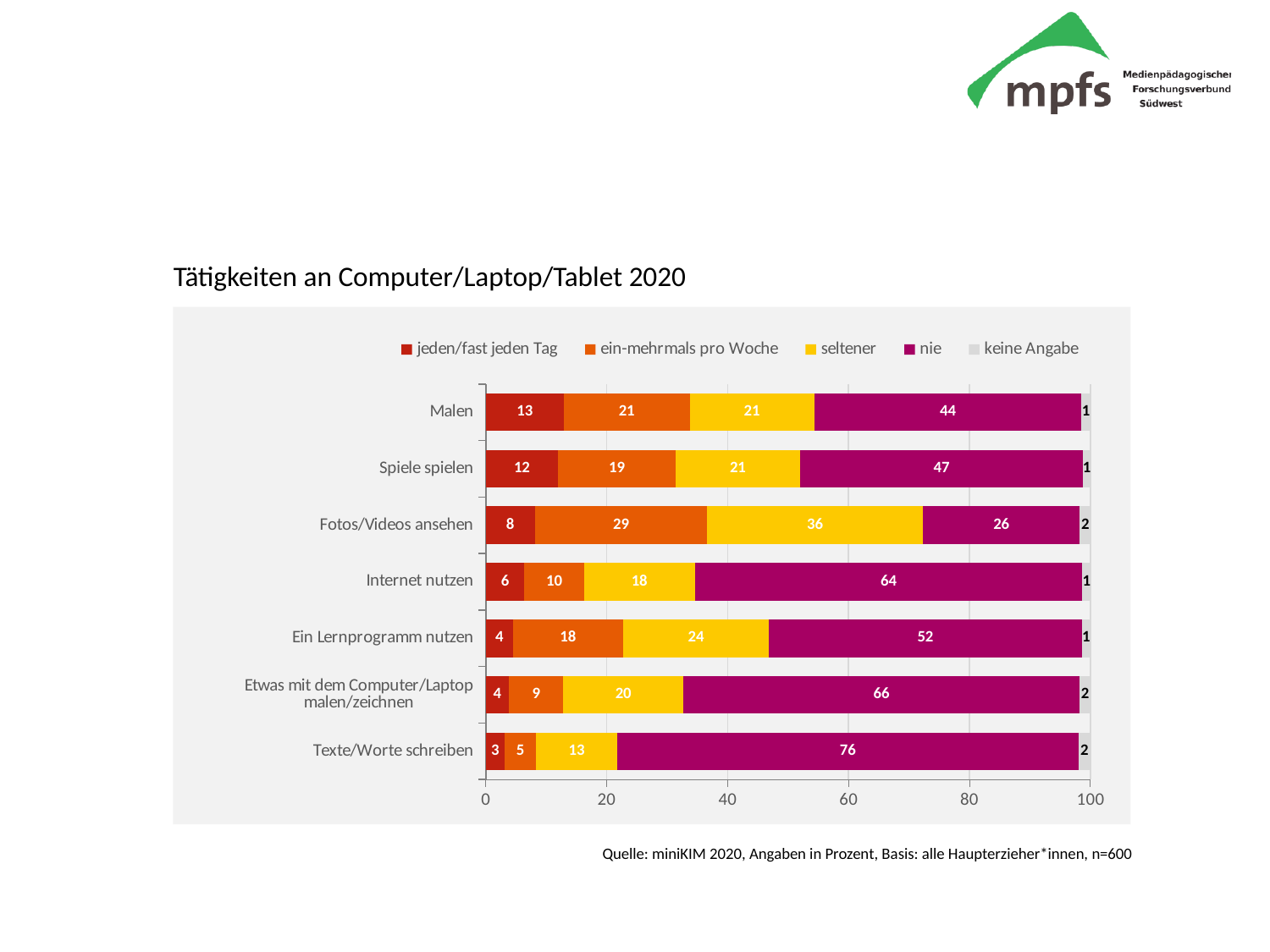
What is the value for "nie" for Texte/Worte schreiben? 76 What kind of chart is shown on the slide? Stacked bar chart How many series does the legend list? 5 Which is larger: the "seltener" value for Fotos/Videos ansehen or for Spiele spielen? Fotos/Videos ansehen Which category has the highest value for "nie"? Texte/Worte schreiben What is the total of the stacked bar for Malen? 100 What is the difference between the "nie" values for Internet nutzen and Malen? 20 Which category has the lowest value for "jeden/fast jeden Tag"? Texte/Worte schreiben What is the value for "jeden/fast jeden Tag" for Malen? 13 What is the value for "ein-mehrmals pro Woche" for Fotos/Videos ansehen? 29 What is the value for "seltener" for Ein Lernprogramm nutzen? 24 How many categories are shown on the chart? 7